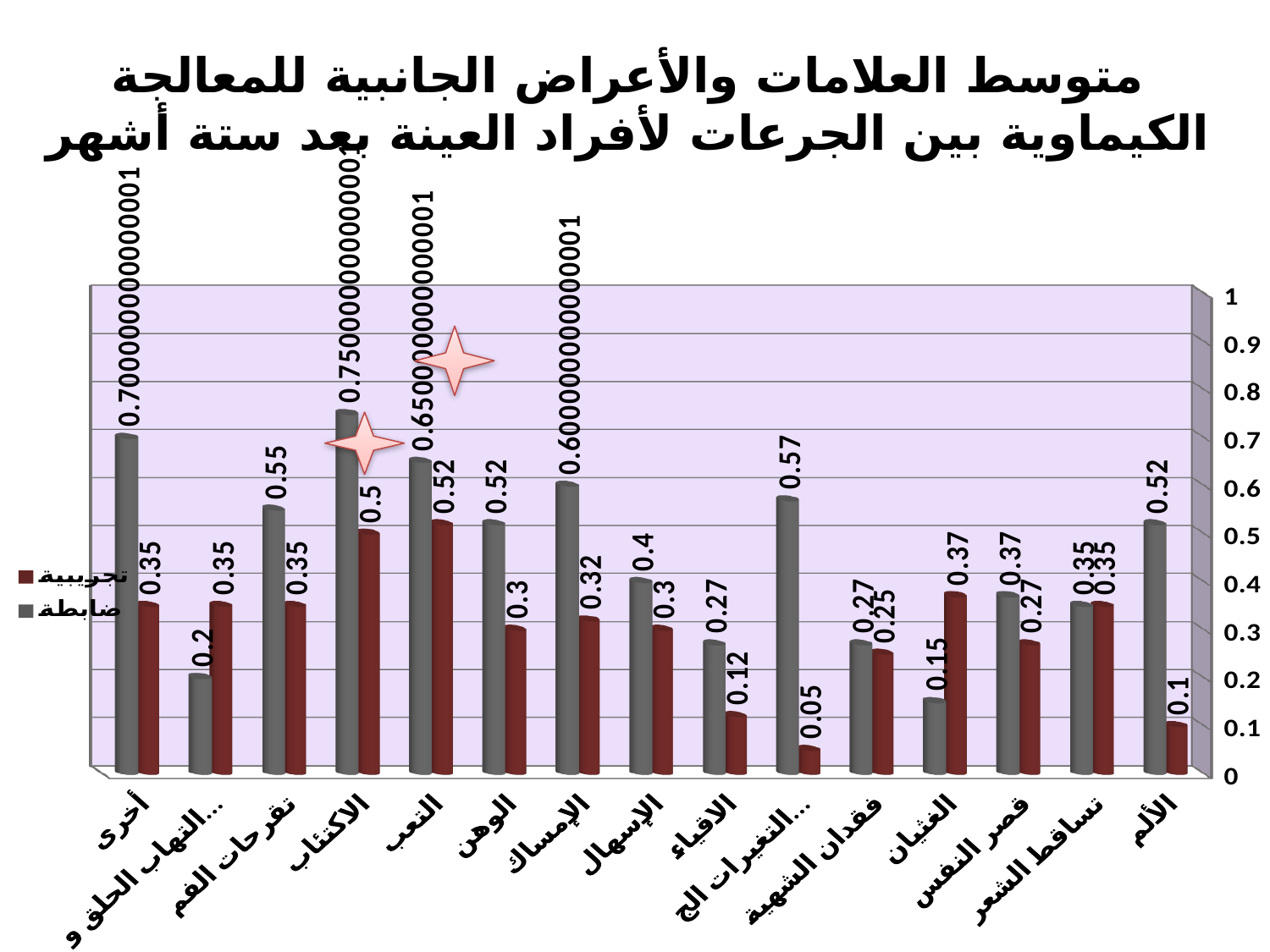
What are the two series named in the legend? تجريبية and ضابطة Which category has the highest ضابطة value? الاكتئاب What type of chart is shown on the slide? bar chart What is the difference between the ضابطة and تجريبية values for الإسهال? 0.1 How many series does the legend list? 2 What is the value of the ضابطة series for الألم? 0.52 Is the ضابطة value for أخرى greater or less than 0.6? greater Which category has the lowest ضابطة value? الغثيان How many categories are shown on the x axis? 15 Which category has the lowest تجريبية value? التغيرات الج... What is the value of the تجريبية series for الغثيان? 0.37 What is the value of the تجريبية series for التغيرات الج...? 0.05